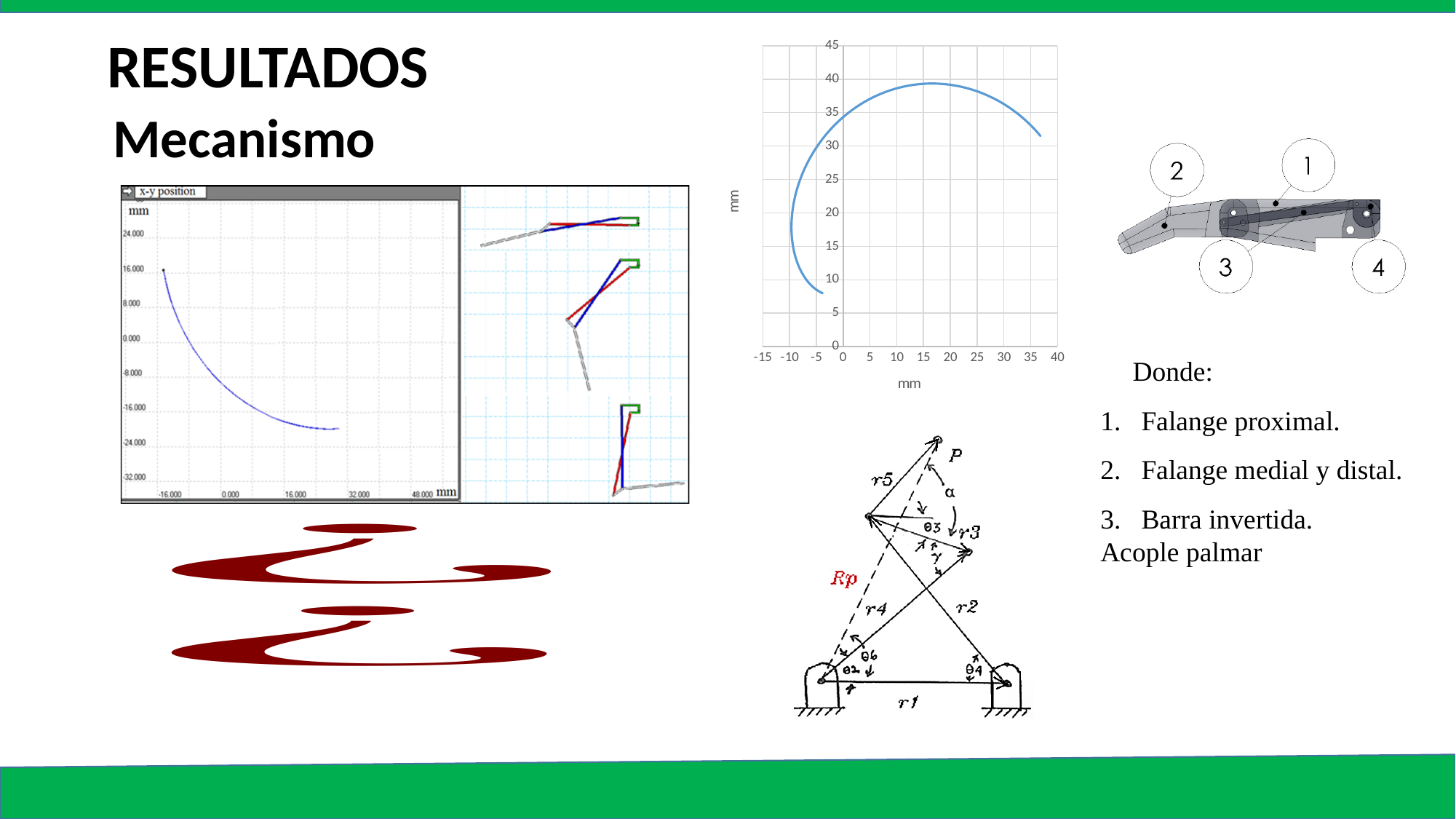
In the top-center chart, is the peak of the blue curve greater or less than 35 mm on the vertical axis? greater In the top-center chart, what is the label on the horizontal axis? mm In the top-center chart, how many curves are plotted? 1 In the top-center chart, is the leftmost point of the blue curve greater or less than -5 mm on the horizontal axis? less In the top-center chart, what is the label on the vertical axis? mm In the top-center chart, what is the highest value shown on the horizontal axis? 40 In the top-center chart, what is the highest value shown on the vertical axis? 45 In the top-center chart, does the blue curve rise or fall as x increases from 20 mm to 35 mm? fall In the top-center chart, is the rightmost point of the blue curve greater or less than 35 mm on the horizontal axis? greater In the top-center chart, what is the lowest value shown on the horizontal axis? -15 What kind of chart is the top-center chart with the blue curve? line chart